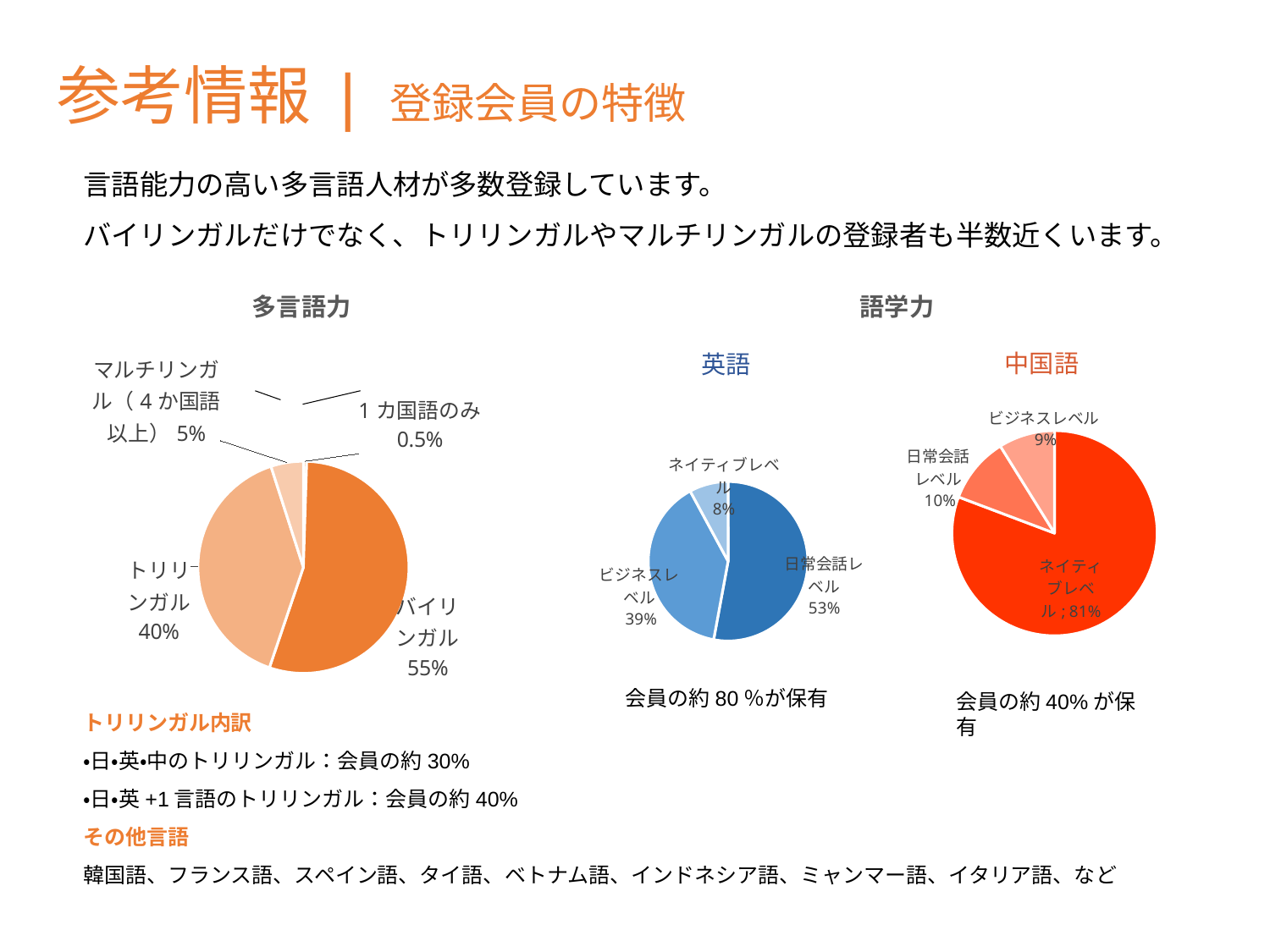
In the 英語 pie chart, what share is 日常会話レベル? 53% In the 多言語力 pie chart, how many slices are there? 4 In the 多言語力 pie chart, which category has the smallest share? 1カ国語のみ In the 多言語力 pie chart, what share is 1カ国語のみ? 0.5% In the 中国語 pie chart, what share is ネイティブレベル? 81% In the 英語 pie chart, what share is ビジネスレベル? 39% In the 多言語力 pie chart, what share is バイリンガル? 55% In the 中国語 pie chart, which is larger, 日常会話レベル or ビジネスレベル? 日常会話レベル In the 多言語力 pie chart, what share is トリリンガル? 40% In the 中国語 pie chart, which level has the largest share? ネイティブレベル In the 英語 pie chart, what is the difference between 日常会話レベル and ネイティブレベル? 45% What type of chart is used for 語学力 (英語 and 中国語)? Pie chart